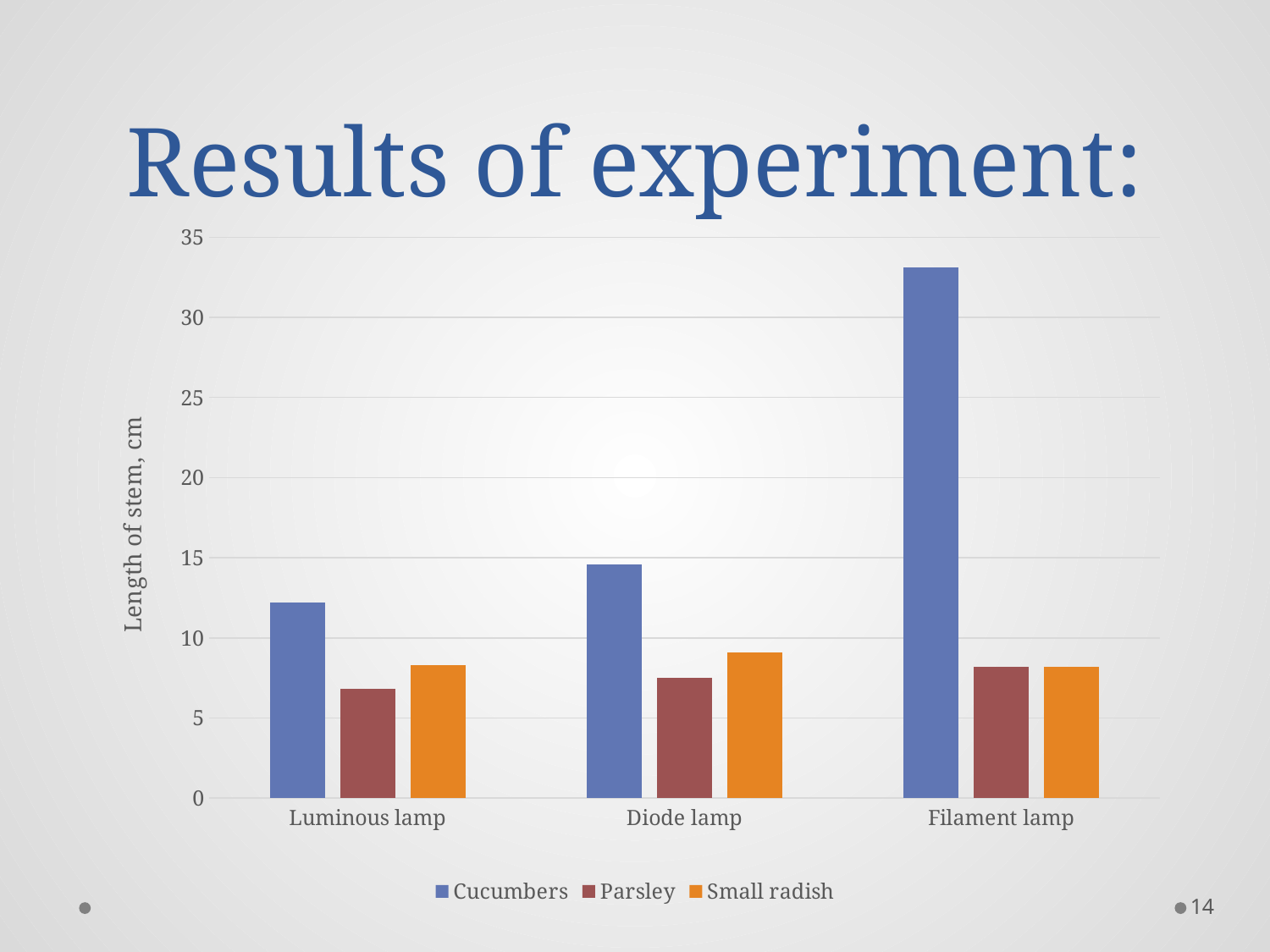
How many series does the legend list? 3 Is the value for Parsley under the Luminous lamp greater or less than 5? greater Is the value for Cucumbers under the Filament lamp greater or less than 30? greater Which is larger under the Filament lamp: the value for Cucumbers or the value for Parsley? Cucumbers What kind of chart is shown on the slide? bar chart How many lamp categories are shown on the x axis? 3 Is the value for Cucumbers under the Diode lamp greater or less than 15? less Do the Cucumbers values rise or fall from Luminous lamp to Filament lamp along the x axis? rise Under which lamp is the Cucumbers stem length lowest? Luminous lamp Under which lamp is the Cucumbers stem length highest? Filament lamp What is the label of the vertical axis? Length of stem, cm